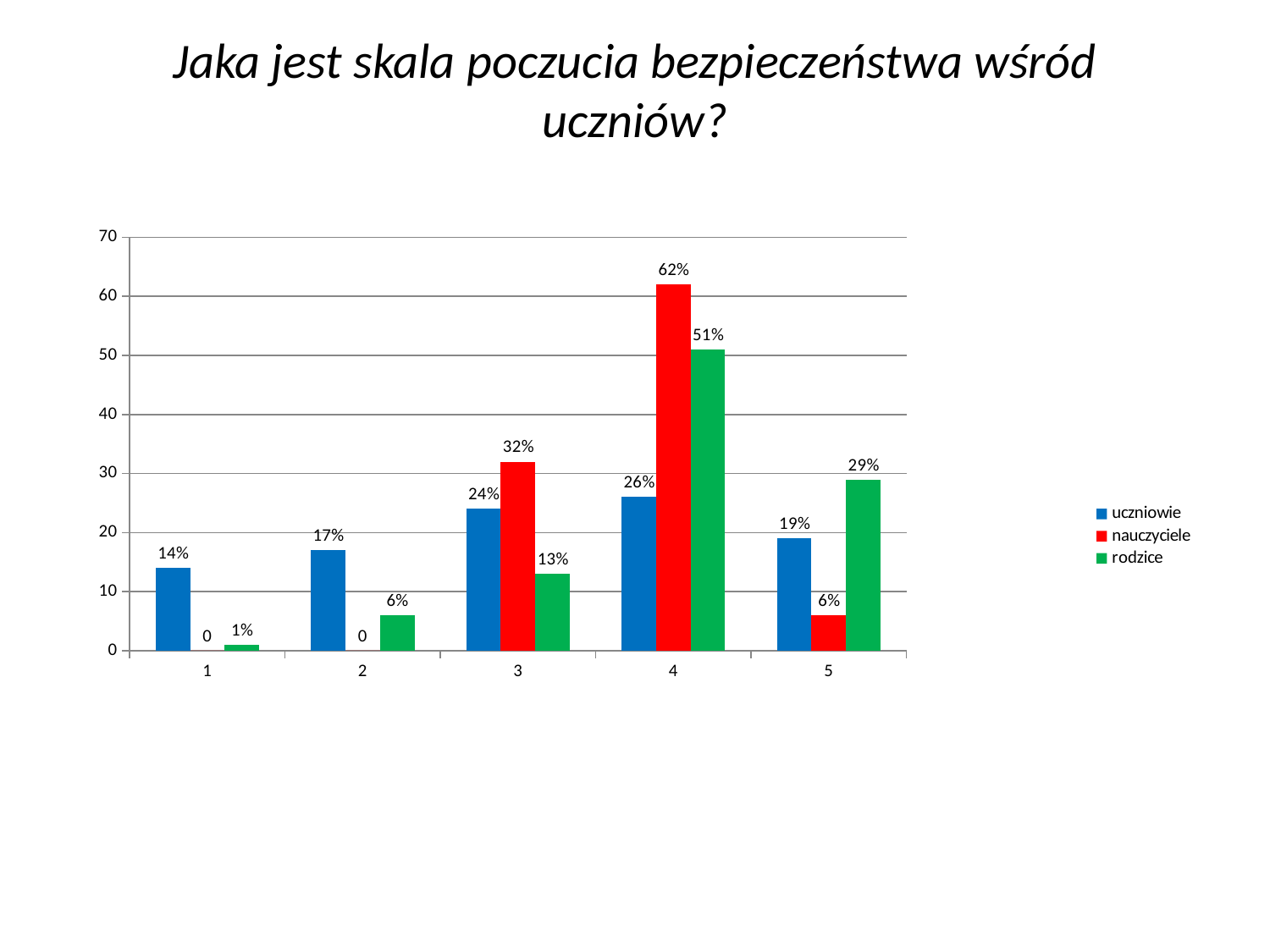
Which category has the lowest value for uczniowie? 1 How many series does the legend list? 3 What is the difference between the nauczyciele and rodzice values at category 4? 11% What kind of chart is shown on the slide? bar chart Which category has the highest value for rodzice? 4 What is the value for nauczyciele at category 1? 0 Which colour represents the nauczyciele series? red How many categories are shown on the x axis? 5 Which is larger at category 5: the value for uczniowie or the value for rodzice? rodzice What is the value for nauczyciele at category 4? 62% What is the value for uczniowie at category 3? 24% What is the value for rodzice at category 5? 29%